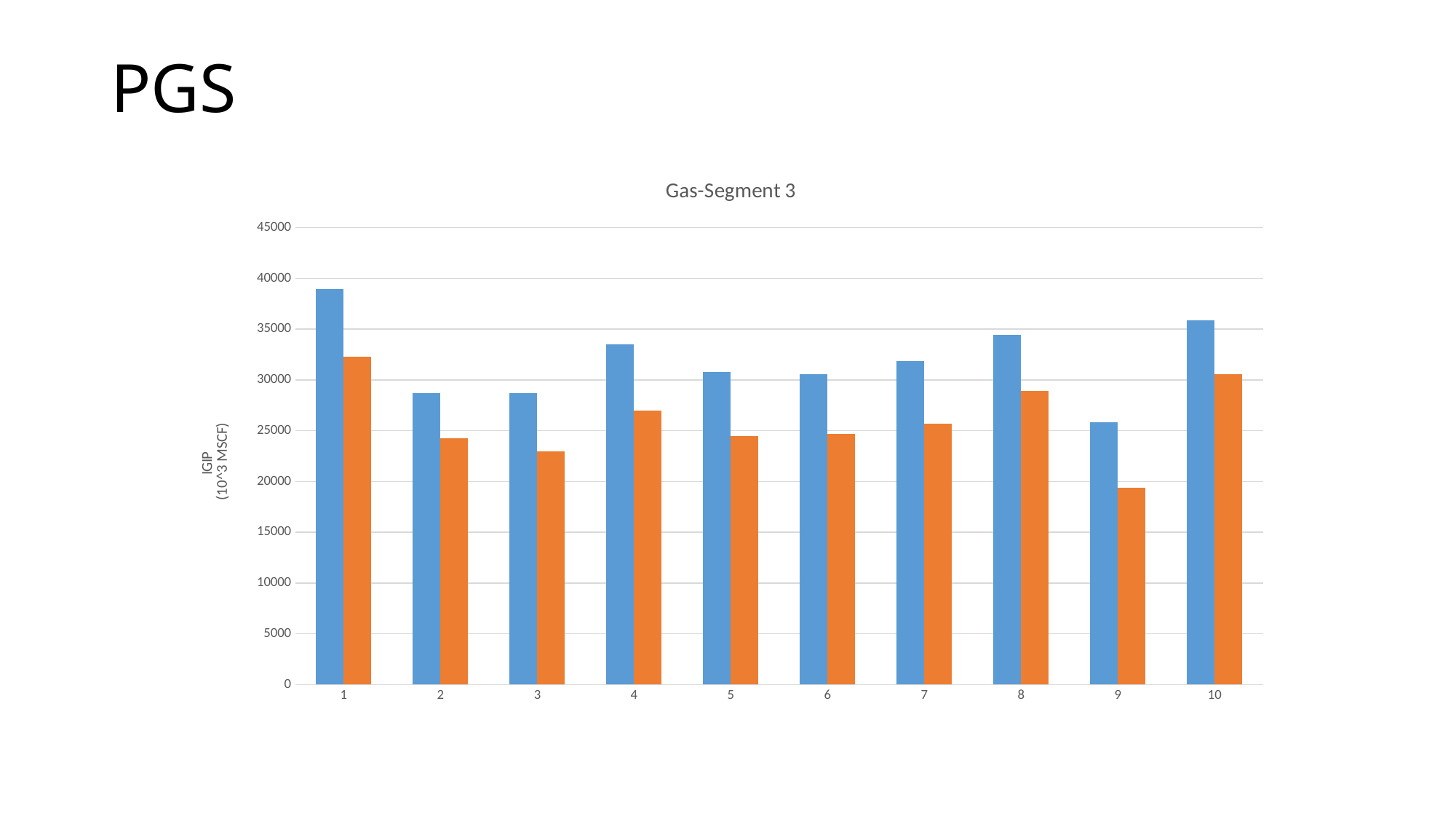
Is the value of the orange bar for category 3 greater or less than 25000? less What kind of chart is shown on the slide? bar chart How many categories are shown on the x axis of the chart? 10 What is the label of the vertical axis? IGIP (10^3 MSCF) Is the value of the blue bar for category 1 greater or less than 35000? greater What is the title of the chart? Gas-Segment 3 Is the value of the orange bar for category 9 greater or less than 25000? less Which is larger, the orange bar for category 8 or the orange bar for category 2? category 8 Which category has the lowest orange bar? 9 Which category has the highest blue bar? 1 Which category has the lowest blue bar? 9